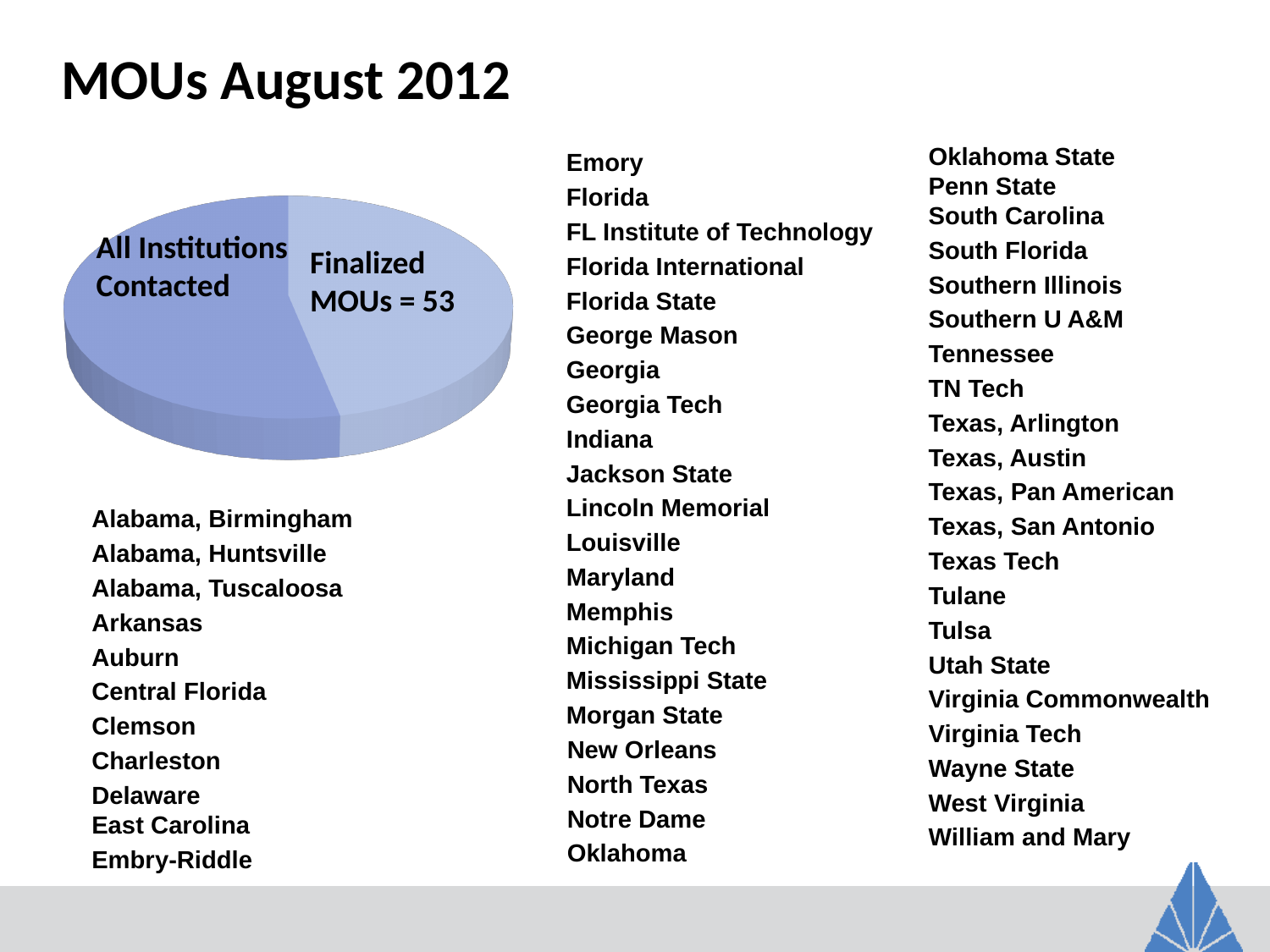
What are the two slice labels shown on the pie chart? All Institutions Contacted; Finalized MOUs = 53 How many slices does the pie chart have? 2 What kind of chart is shown on the slide? pie chart What value is printed for the Finalized MOUs slice of the pie chart? 53 What is the title of the slide containing the pie chart? MOUs August 2012